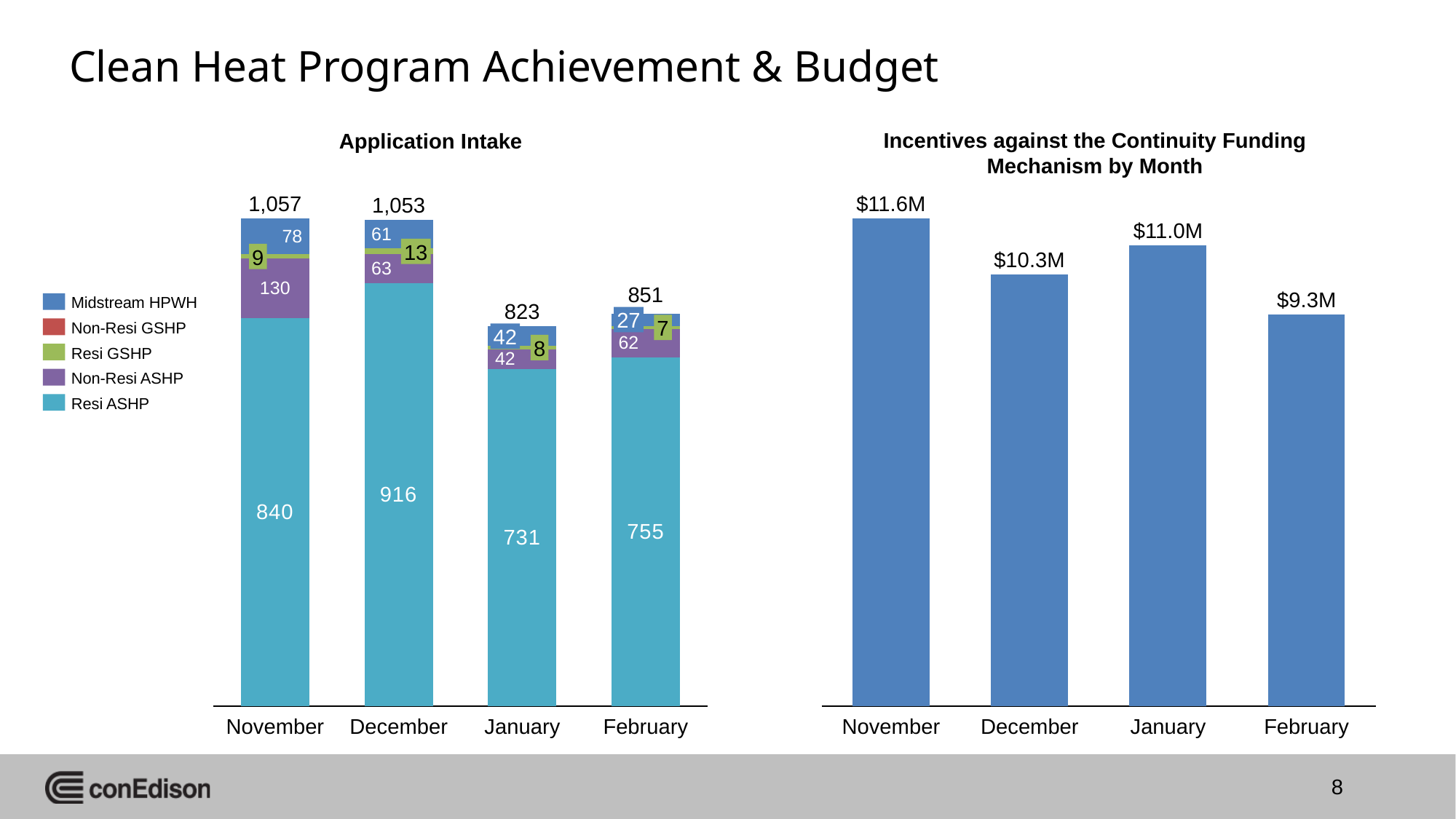
How many series does the legend of the Application Intake chart list? 5 In the Incentives against the Continuity Funding Mechanism by Month chart, what is the value for December? $10.3M What kind of chart is the Incentives against the Continuity Funding Mechanism by Month chart? Bar chart In the Incentives against the Continuity Funding Mechanism by Month chart, which month has the highest value? November In the Application Intake chart, which month has the lowest total? January In the Application Intake chart, what is the Resi ASHP value for December? 916 In the Application Intake chart, what is the difference between the Resi ASHP values for December and January? 185 In the Application Intake chart, what is the Non-Resi ASHP value for November? 130 In the Application Intake chart, what is the Midstream HPWH value for February? 27 In the Application Intake chart, what is the total number of applications for November? 1,057 How many months are shown in the Incentives against the Continuity Funding Mechanism by Month chart? 4 In the Incentives against the Continuity Funding Mechanism by Month chart, which is larger, January or February? January